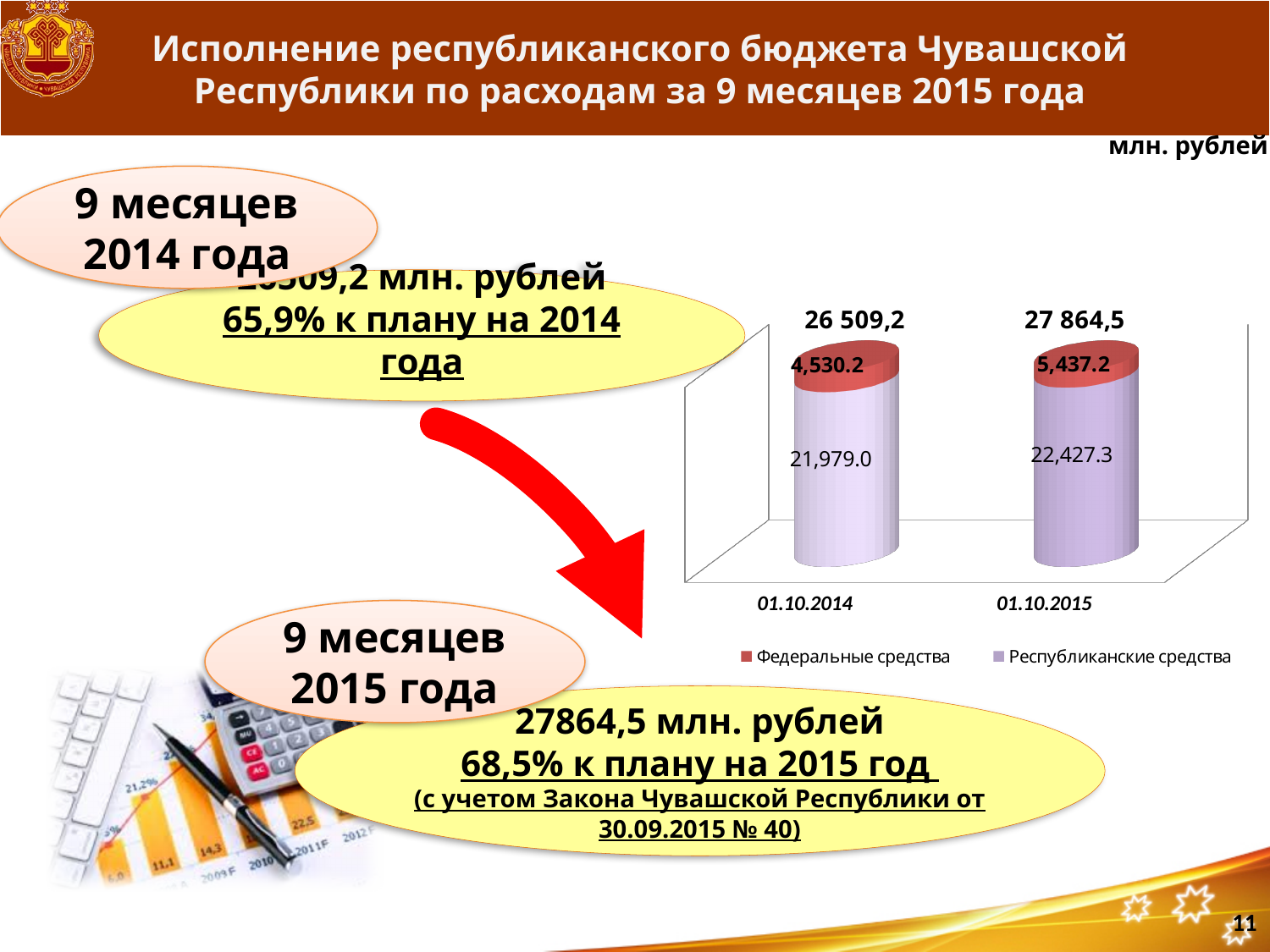
What is the value for Республиканские средства on 01.10.2014? 21,979.0 How many categories are shown on the x axis? 2 What is the difference between the Республиканские средства values for 01.10.2015 and 01.10.2014? 448.3 How many series does the legend list? 2 What is the total of the stacked bar for 01.10.2014? 26 509,2 What is the value for Федеральные средства on 01.10.2014? 4,530.2 What is the difference between the Федеральные средства values for 01.10.2015 and 01.10.2014? 907.0 What is the total of the stacked bar for 01.10.2015? 27 864,5 What is the value for Федеральные средства on 01.10.2015? 5,437.2 Which date has the larger total, 01.10.2014 or 01.10.2015? 01.10.2015 What is the value for Республиканские средства on 01.10.2015? 22,427.3 What kind of chart is shown on the slide? Stacked bar chart